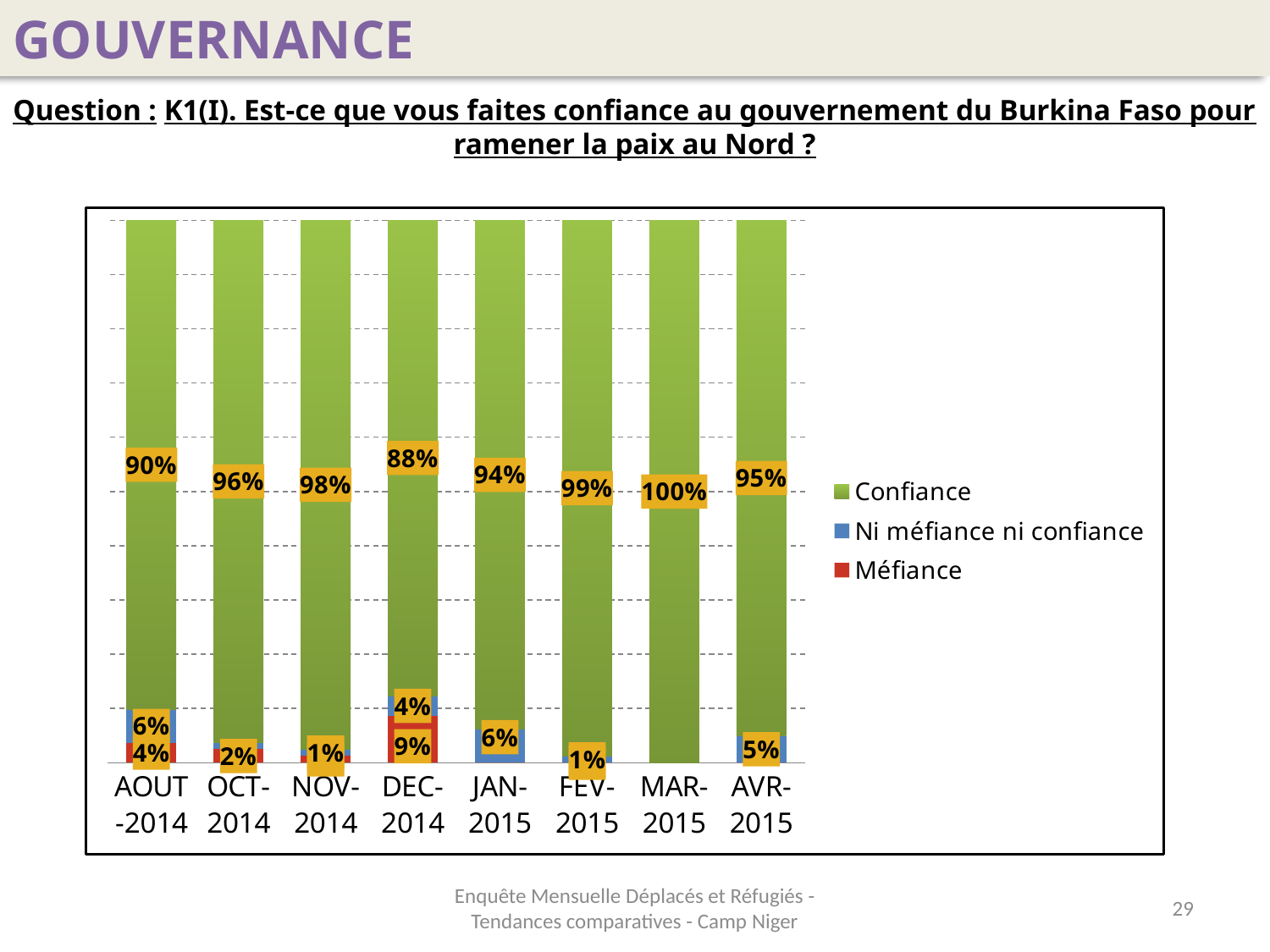
How many months (categories) are shown on the x axis? 8 What is the Méfiance value for DEC-2014? 9% What type of chart is shown on the slide? stacked bar chart What is the Confiance value for MAR-2015? 100% What is the Ni méfiance ni confiance value for JAN-2015? 6% How many series does the legend list? 3 Which is larger, the Confiance value for OCT-2014 or for AVR-2015? OCT-2014 What is the Confiance value for DEC-2014? 88% What is the Confiance value for AOUT-2014? 90% Which month has the lowest Confiance value? DEC-2014 What is the difference between the Confiance values for NOV-2014 and DEC-2014? 10% Which month has the highest Confiance value? MAR-2015